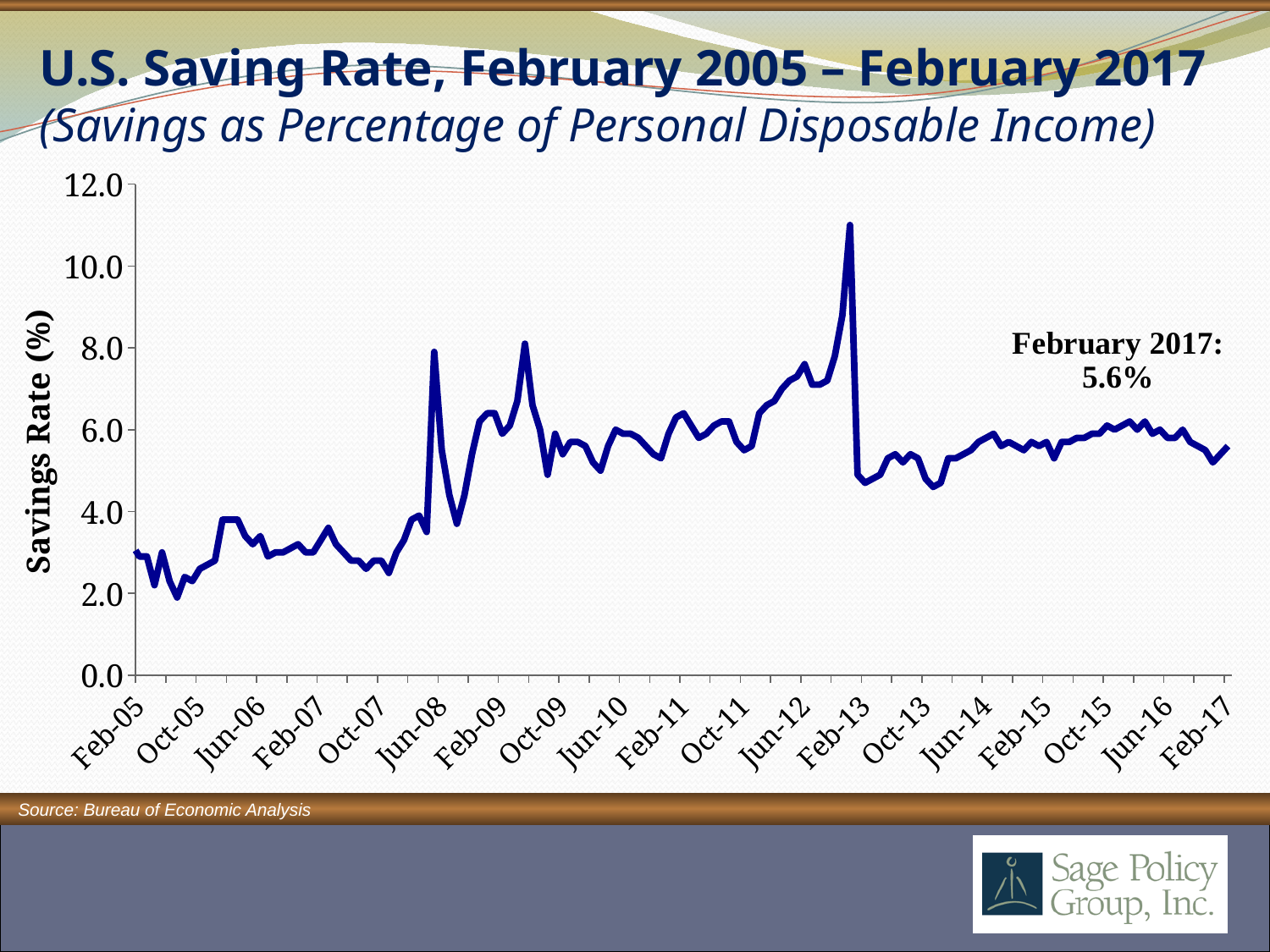
Is the value at Jun-12 greater or less than 6.0? greater Is the highest point on the line greater or less than 10.0? greater What is the U.S. saving rate for February 2017 according to the label on the chart? 5.6% What kind of chart is shown on the slide? Line chart Which is larger, the value at Feb-05 or the value at Feb-17? Feb-17 Overall, does the saving rate rise or fall from Feb-05 to Feb-17? rise Is the value at Feb-05 greater or less than 4.0? less What is the title of the vertical axis? Savings Rate (%) What source is cited for the chart data? Bureau of Economic Analysis How many date labels are shown on the x axis? 19